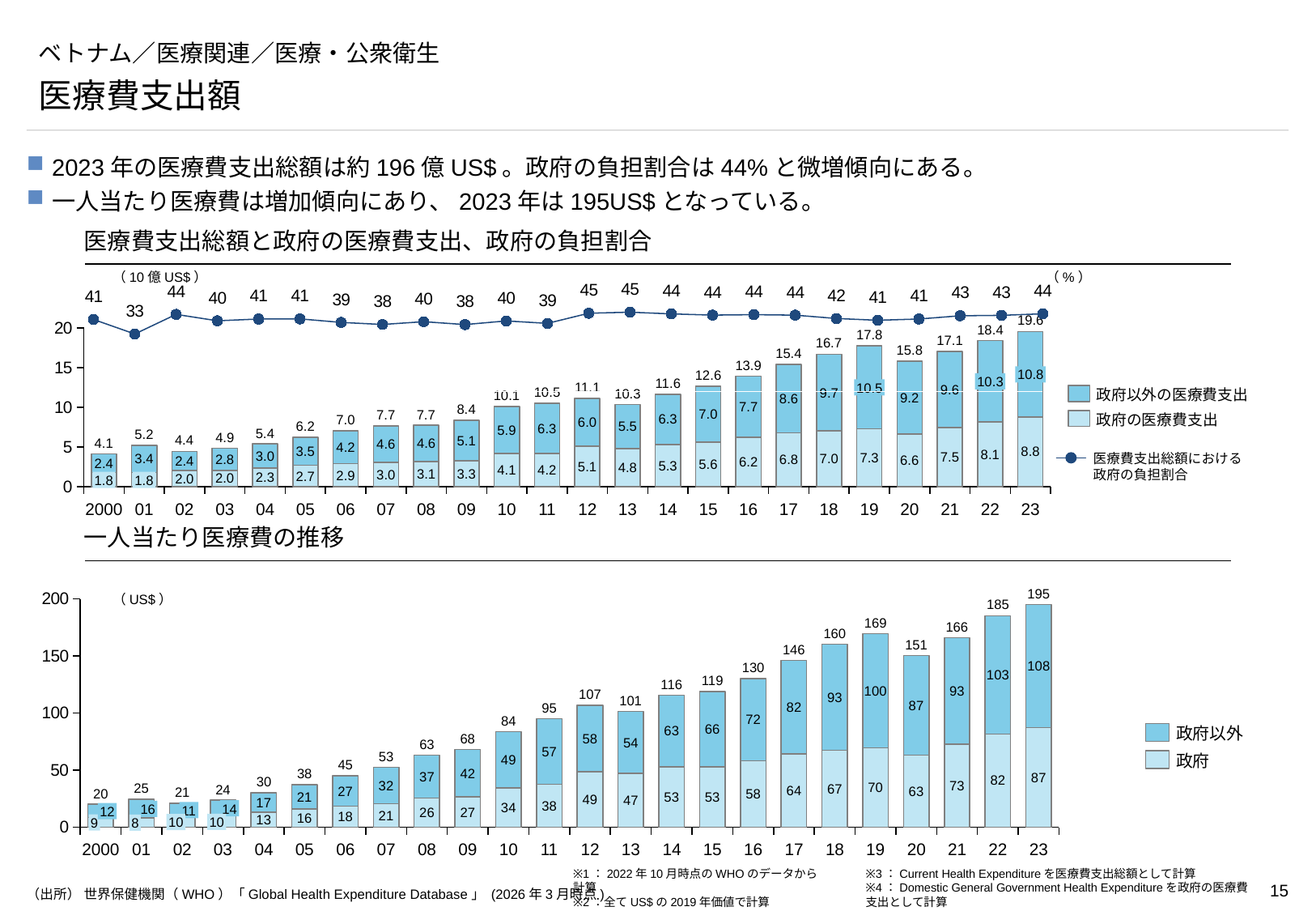
What kind of chart is the bottom chart (一人当たり医療費の推移)? Stacked bar chart In the top chart (医療費支出総額と政府の医療費支出、政府の負担割合), what is the total health expenditure for 2023? 19.6 In the bottom chart, what is the government (政府) value for 2023? 87 In the bottom chart, how many years are plotted on the x axis? 24 In the bottom chart, which year has the highest total per-capita health expenditure? 2023 In the top chart, what is the government health expenditure (政府の医療費支出) for 2023? 8.8 In the bottom chart (一人当たり医療費の推移), what is the total per-capita health expenditure for 2023? 195 In the top chart, what is the government share (政府の負担割合) for 2001? 33 In the bottom chart, what is the difference between the total for 2023 and the total for 2022? 10 In the top chart, which year has the lowest total health expenditure? 2000 In the top chart, how many entries does the legend list? 3 In the top chart, which year has the lowest government share (政府の負担割合)? 2001